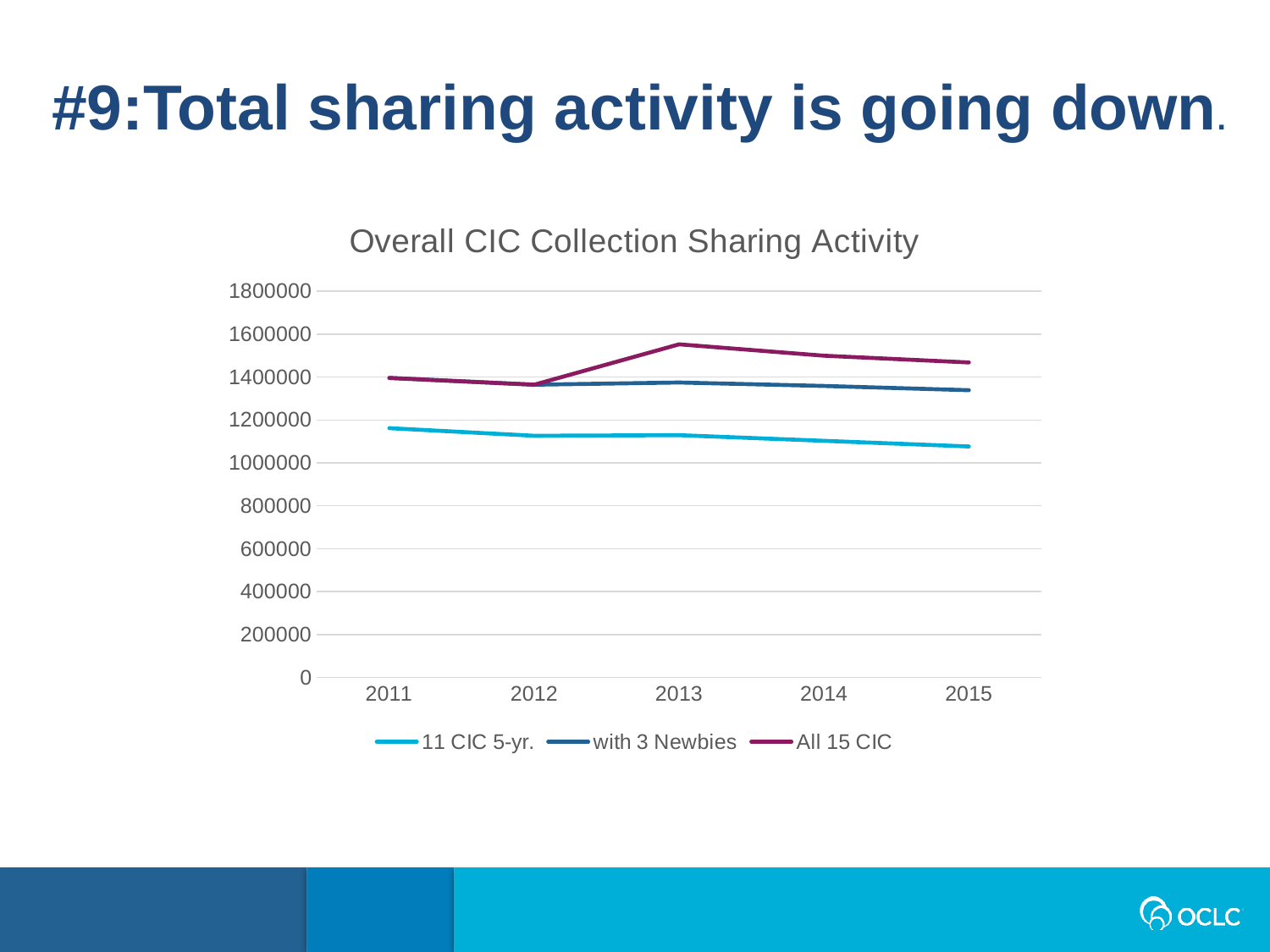
In 2015, which is larger: All 15 CIC or 11 CIC 5-yr.? All 15 CIC Does the 11 CIC 5-yr. series rise or fall from 2011 to 2015? Fall Is the value for 11 CIC 5-yr. in 2011 greater or less than 1200000? less What is the title of the chart? Overall CIC Collection Sharing Activity What kind of chart is shown on the slide? Line chart Which series is plotted with the purple line? All 15 CIC How many series does the legend list? 3 Is the value for All 15 CIC in 2013 greater or less than 1400000? greater How many years are shown on the x axis? 5 Is the value for with 3 Newbies in 2015 greater or less than 1400000? less In which year does the All 15 CIC series reach its highest value? 2013 Which series has the lowest values across all years? 11 CIC 5-yr.